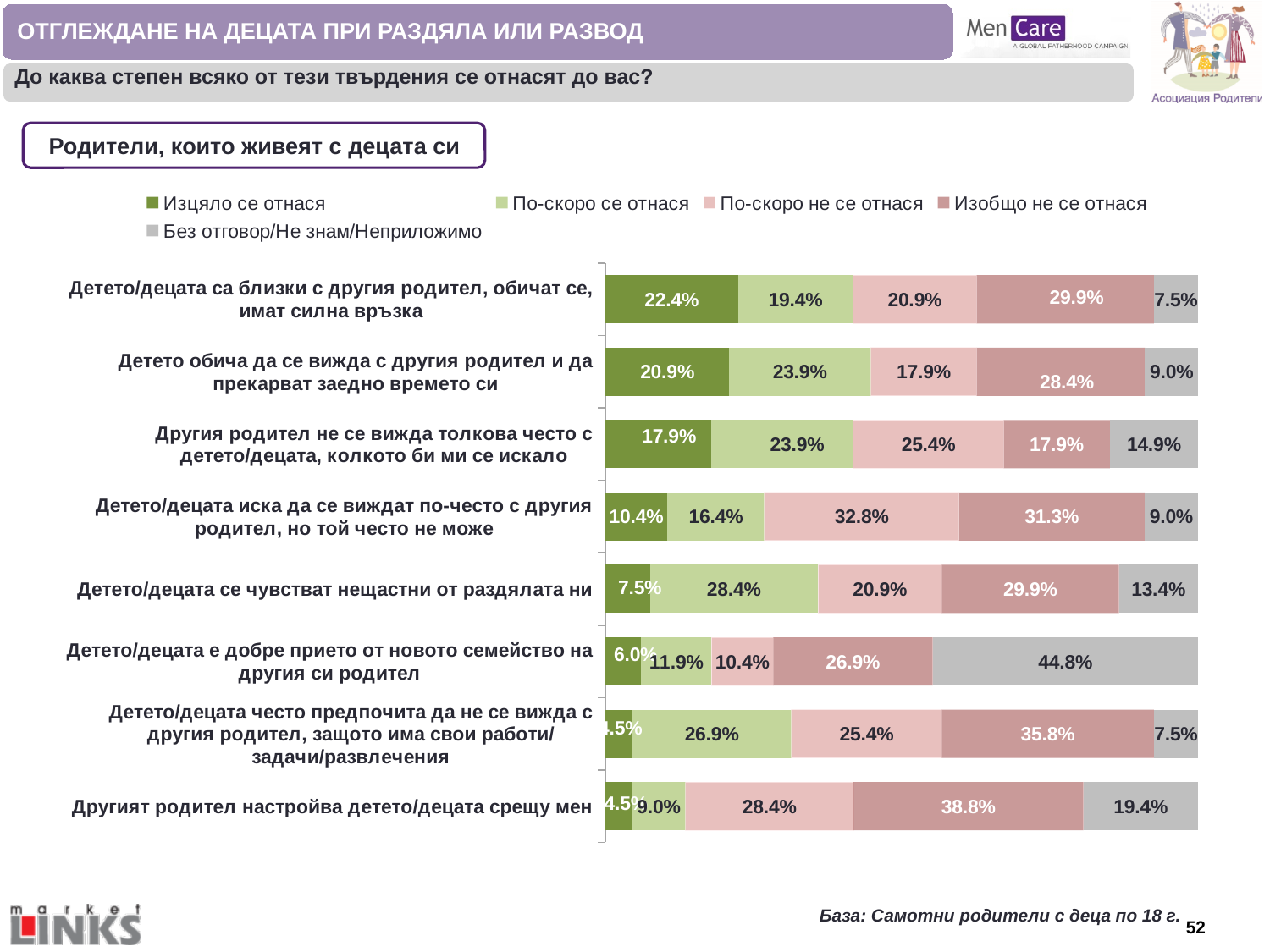
How many statements (categories) are plotted in the chart? 8 What is the value of "По-скоро не се отнася" for the statement "Детето/децата иска да се виждат по-често с другия родител, но той често не може"? 32.8% What kind of chart is shown on the slide? Stacked bar chart For the statement "Детето обича да се вижда с другия родител и да прекарват заедно времето си", which is larger: "По-скоро се отнася" or "По-скоро не се отнася"? По-скоро се отнася How many series does the legend list? 5 Which statement has the highest value for "Изцяло се отнася"? Детето/децата са близки с другия родител, обичат се, имат силна връзка What is the value of "Без отговор/Не знам/Неприложимо" for the statement "Детето/децата е добре прието от новото семейство на другия си родител"? 44.8% What is the difference between the "Изобщо не се отнася" value and the "Изцяло се отнася" value for the statement "Детето/децата се чувстват нещастни от раздялата ни"? 22.4% What is the value of "Изцяло се отнася" for the statement "Детето/децата са близки с другия родител, обичат се, имат силна връзка"? 22.4% What is the value of "Изобщо не се отнася" for the statement "Другият родител настройва детето/децата срещу мен"? 38.8% Which legend entry is shown in grey? Без отговор/Не знам/Неприложимо Which statement has the highest value for "Без отговор/Не знам/Неприложимо"? Детето/децата е добре прието от новото семейство на другия си родител